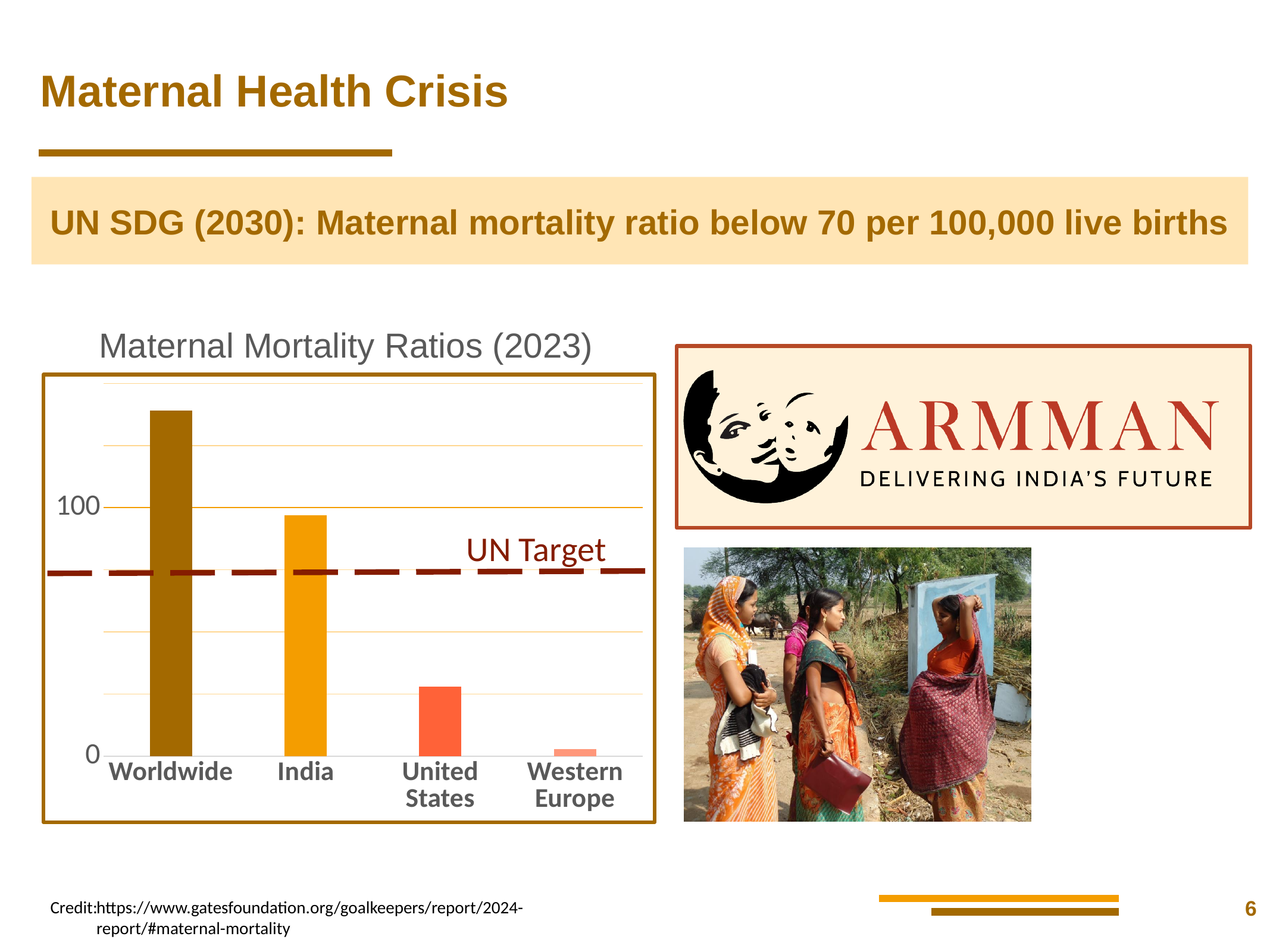
What does the dashed horizontal line in the chart represent? UN Target Do the bar values rise or fall from left to right across the categories? fall Is the value for Worldwide greater or less than 100? greater Which is larger, the value for India or the value for United States? India Which category has the lowest maternal mortality ratio in the chart? Western Europe Which category has the highest maternal mortality ratio in the chart? Worldwide Is the value for United States greater or less than 100? less How many categories are plotted in the chart? 4 What kind of chart is shown on the slide? bar chart What is the title of the chart? Maternal Mortality Ratios (2023) Is the value for India greater or less than 100? less Which is larger, the value for United States or the value for Western Europe? United States